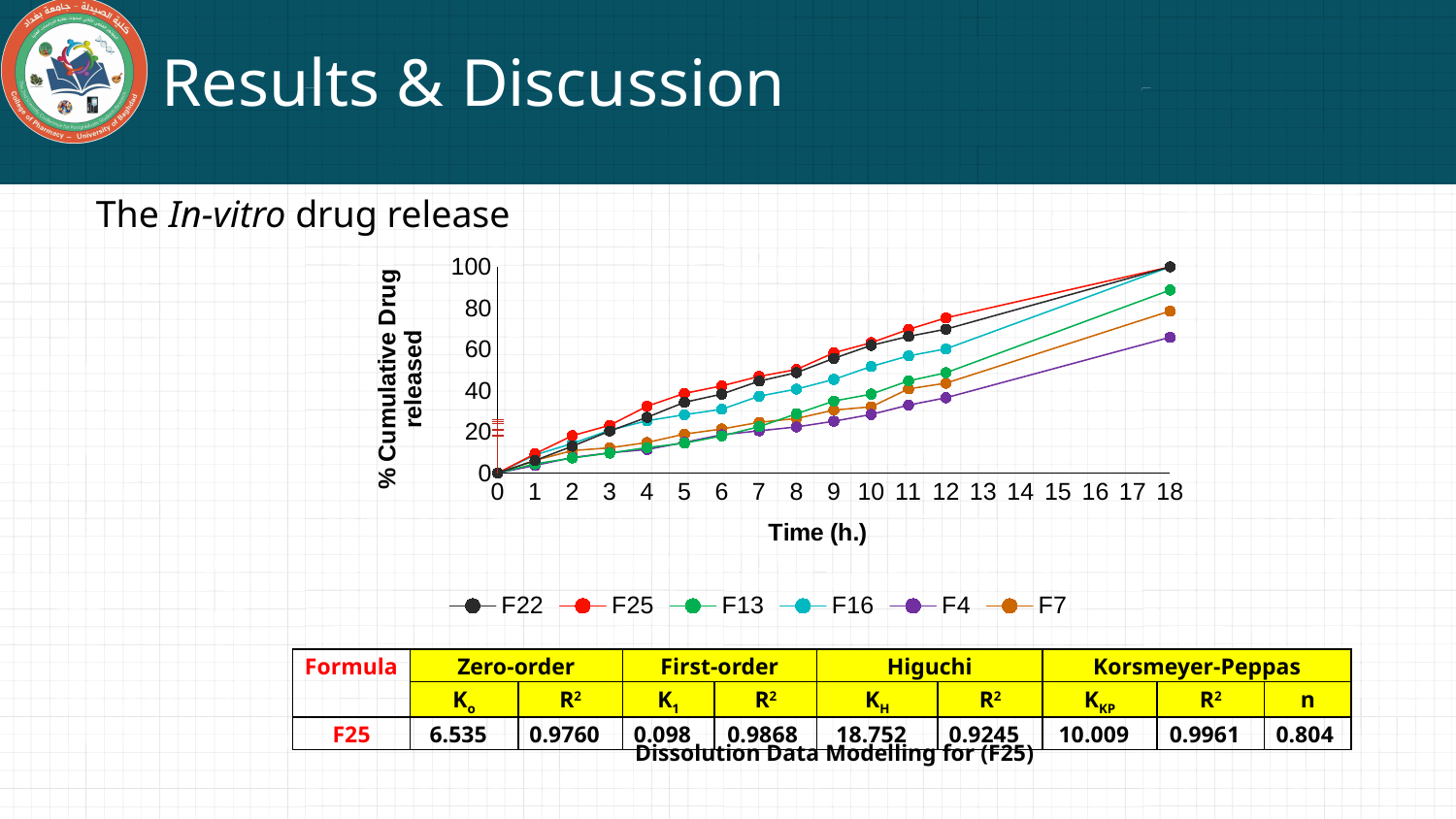
Which series has the highest % cumulative drug released at 12 h? F25 Is the value for F4 at 18 h greater or less than 80? less At 18 h, which series has the larger value, F13 or F7? F13 What is the title of the x axis of the chart? Time (h.) Which series has the lowest % cumulative drug released at 12 h? F4 Is the value for F25 at 12 h greater or less than 60? greater What kind of chart is shown on the slide? line chart Which series has the lowest % cumulative drug released at 18 h? F4 How many series does the chart legend list? 6 What is the title of the y axis of the chart? % Cumulative Drug released Is the value for F4 at 6 h greater or less than 40? less Do the values for F25 rise or fall as time increases along the x axis? rise